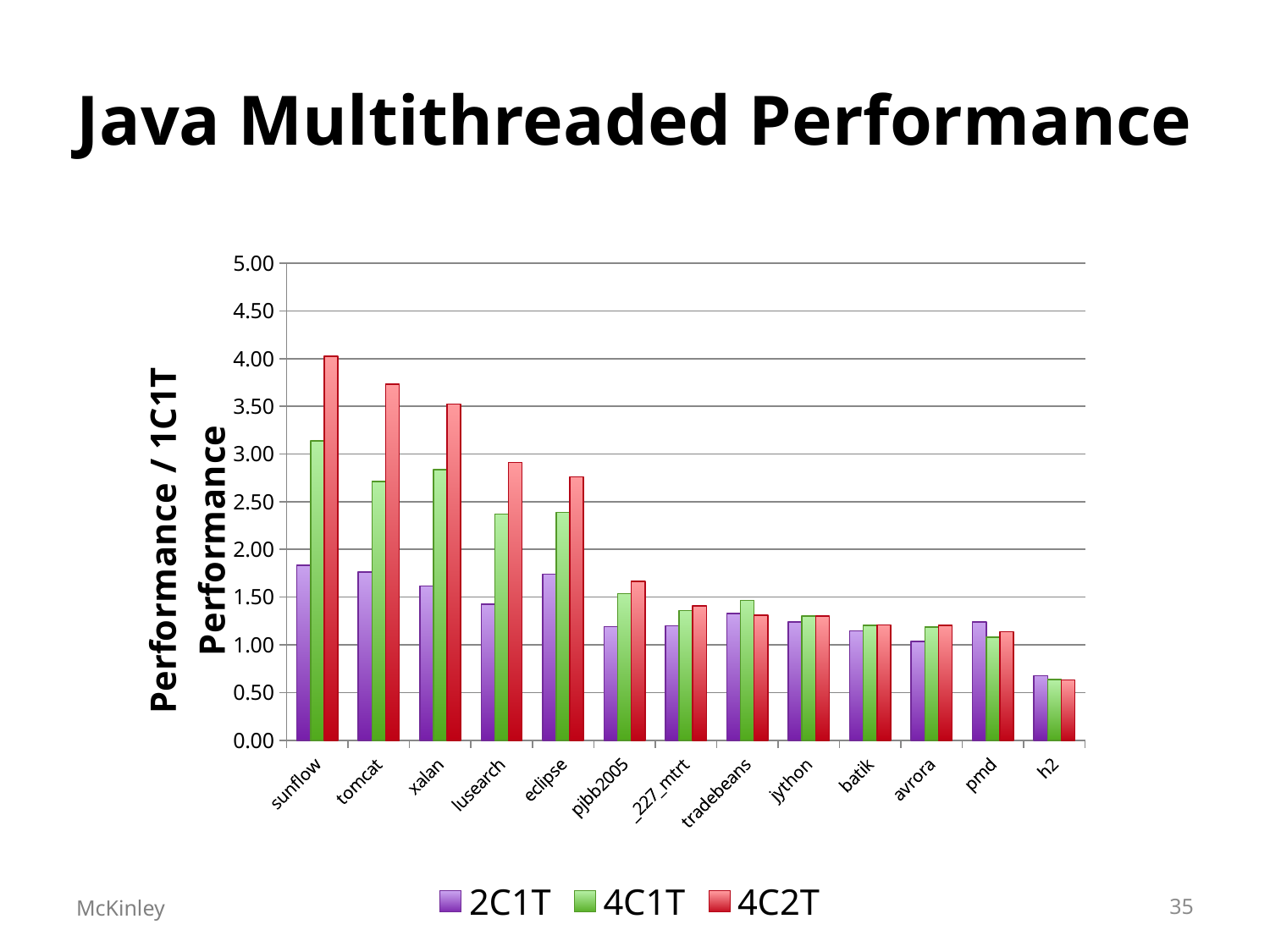
Is the 4C2T value for tomcat greater or less than 3.50? greater Is the 2C1T value for h2 greater or less than 1.00? less Do the 4C2T values generally rise or fall moving from left to right along the x axis? fall How many benchmark categories are shown on the x axis? 13 Is the 4C2T value for eclipse greater or less than 2.50? greater Which benchmark has the highest 4C2T value? sunflow What kind of chart is shown on the slide? bar chart How many series does the legend list? 3 Which is larger, the 4C2T value for pjbb2005 or the 4C2T value for tradebeans? pjbb2005 Which benchmark has the lowest 4C2T value? h2 Which is larger, the 4C2T value for tomcat or the 4C2T value for xalan? tomcat